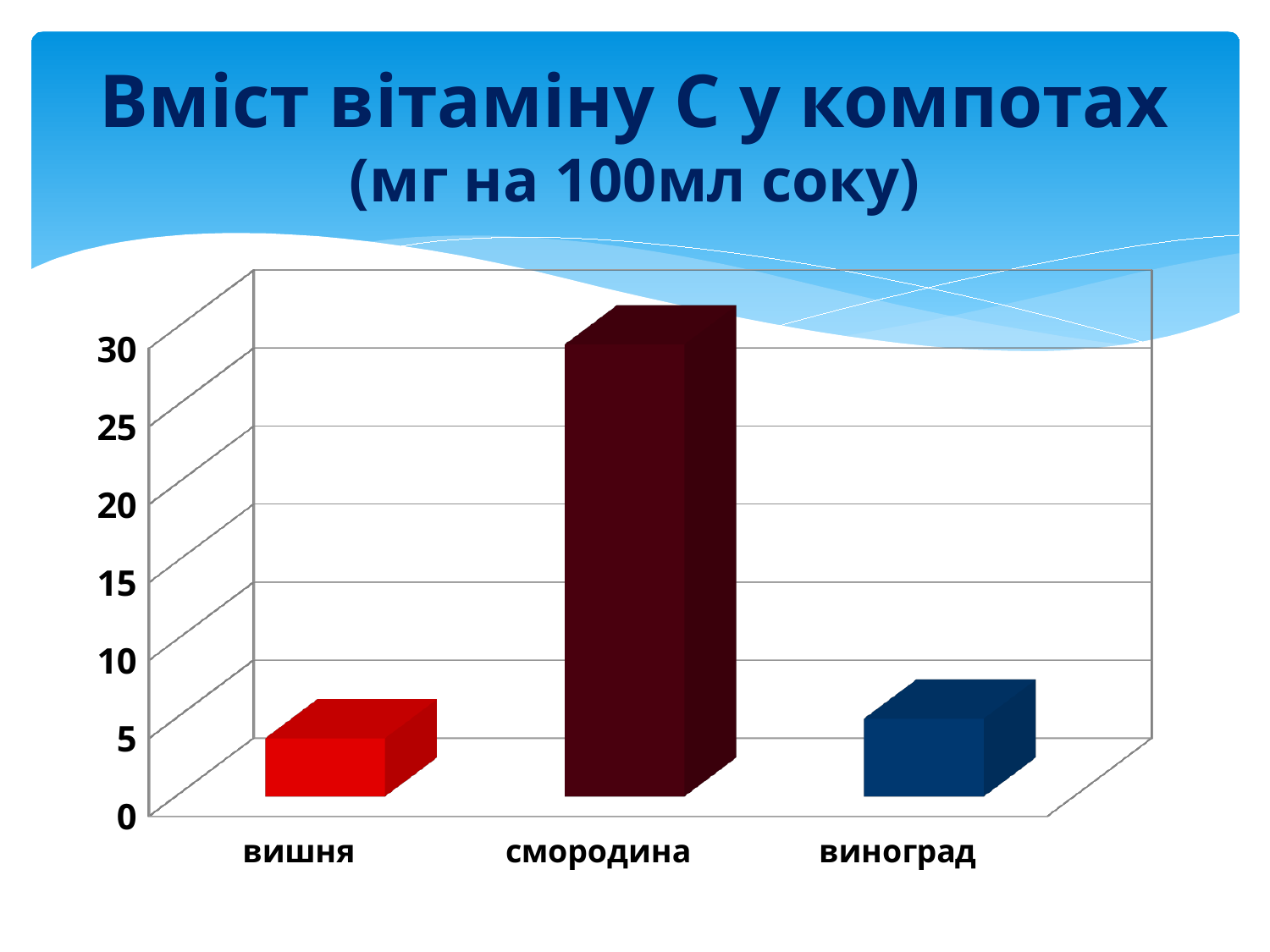
Is the value for вишня greater or less than 15? less What colour is the bar for виноград? blue What is the title of the chart on the slide? Вміст вітаміну С у компотах (мг на 100мл соку) Is the value for смородина greater or less than 20? greater Is the value for смородина greater or less than 25? greater How many categories are shown on the x axis of the chart? 3 Which is larger, the value for смородина or the value for виноград? смородина What kind of chart is shown on the slide? bar chart Which is larger, the value for смородина or the value for вишня? смородина Which category has the highest vitamin C content in the chart? смородина